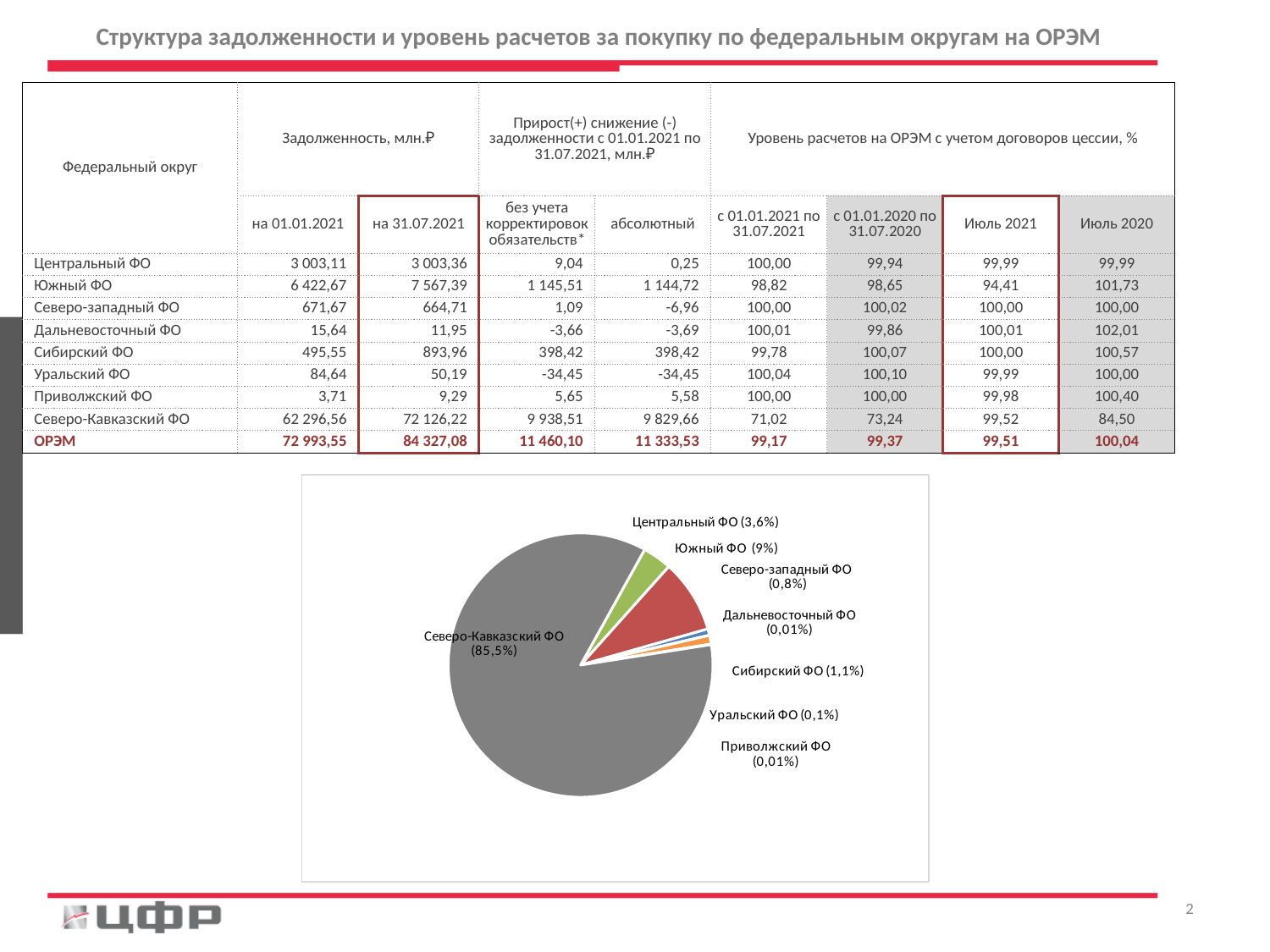
What share of the pie does Южный ФО have? 9% What share of the pie does Уральский ФО have? 0,1% What is the difference in share between Северо-Кавказский ФО and Южный ФО in the pie chart? 76,5% What share of the pie does Северо-западный ФО have? 0,8% What colour is the Северо-Кавказский ФО slice in the pie chart? grey Which slice is larger in the pie chart, Южный ФО or Центральный ФО? Южный ФО How many slices does the pie chart have? 8 What kind of chart is shown on the slide? pie chart Which slice of the pie chart is the largest? Северо-Кавказский ФО